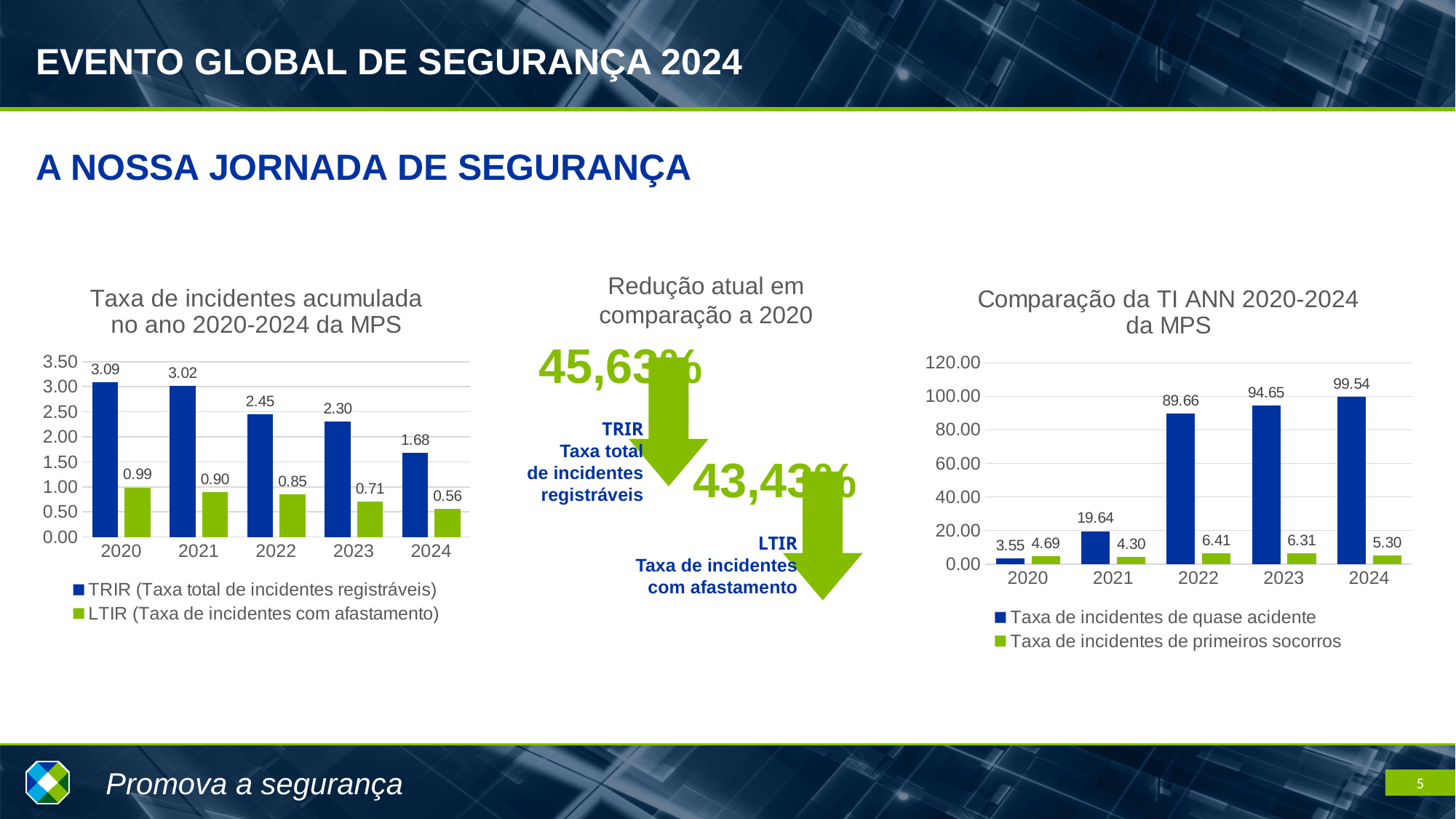
In the chart 'Comparação da TI ANN 2020-2024 da MPS', how many years are shown on the x axis? 5 In the chart 'Comparação da TI ANN 2020-2024 da MPS', which is larger in 2020: 'Taxa de incidentes de quase acidente' or 'Taxa de incidentes de primeiros socorros'? Taxa de incidentes de primeiros socorros In the chart 'Taxa de incidentes acumulada no ano 2020-2024 da MPS', does the TRIR series rise or fall from 2020 to 2024? Fall In the chart 'Taxa de incidentes acumulada no ano 2020-2024 da MPS', what is the TRIR value for 2020? 3.09 In the chart 'Taxa de incidentes acumulada no ano 2020-2024 da MPS', which year has the lowest TRIR value? 2024 What type of chart is 'Comparação da TI ANN 2020-2024 da MPS'? Bar chart In the chart 'Taxa de incidentes acumulada no ano 2020-2024 da MPS', how many series does the legend list? 2 In the chart 'Taxa de incidentes acumulada no ano 2020-2024 da MPS', what is the LTIR value for 2024? 0.56 In the chart 'Comparação da TI ANN 2020-2024 da MPS', what is the value of 'Taxa de incidentes de primeiros socorros' for 2022? 6.41 In the chart 'Comparação da TI ANN 2020-2024 da MPS', which year has the highest value for 'Taxa de incidentes de quase acidente'? 2024 In the chart 'Comparação da TI ANN 2020-2024 da MPS', what is the value of 'Taxa de incidentes de quase acidente' for 2024? 99.54 In the chart 'Taxa de incidentes acumulada no ano 2020-2024 da MPS', what is the difference between the TRIR values for 2020 and 2024? 1.41